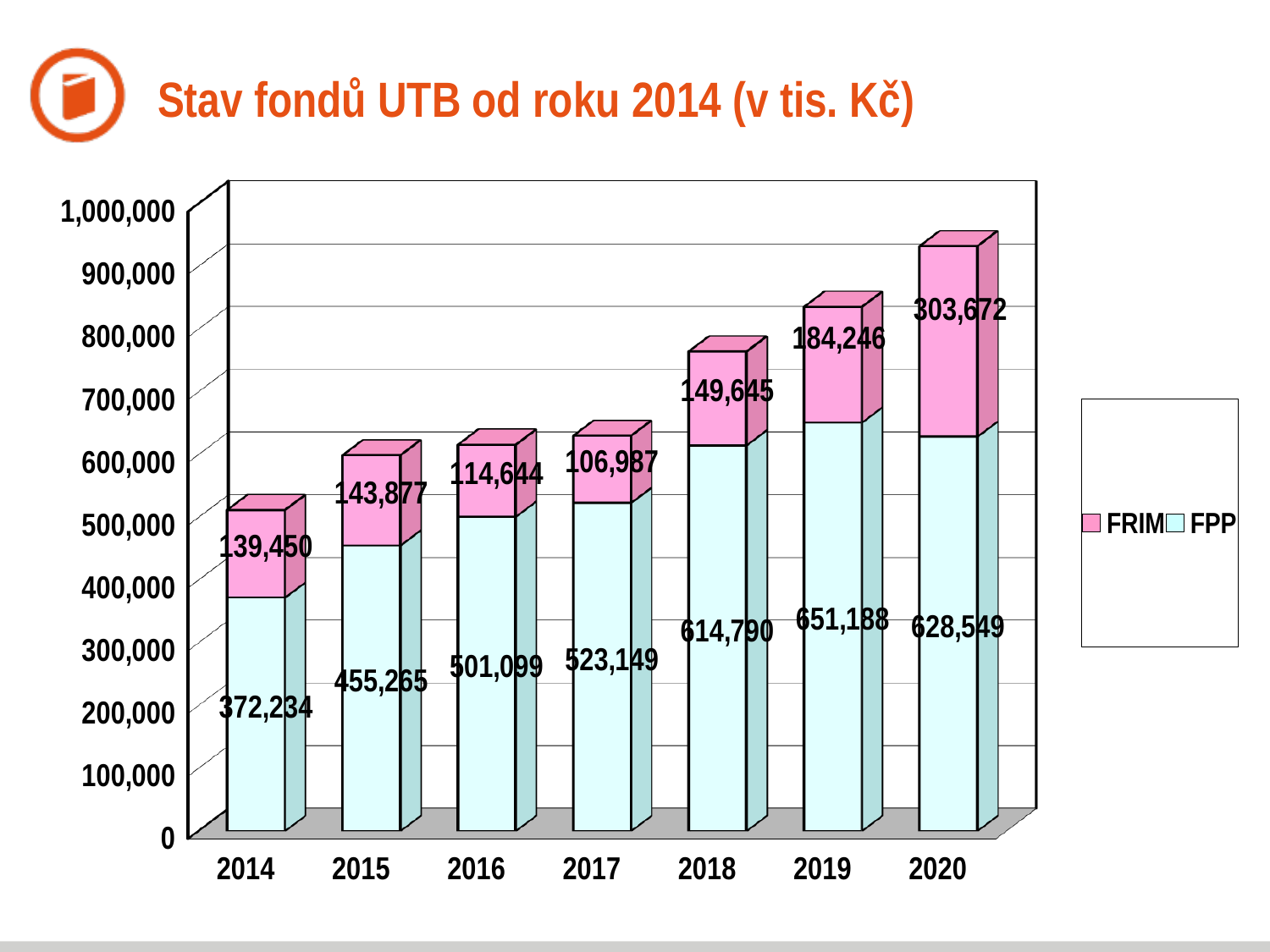
In which year is the FRIM value highest? 2020 How many series does the legend list? 2 How many years are shown on the x axis? 7 What is the total of the stacked bar for 2020? 932,221 Which year has the larger FRIM value, 2015 or 2016? 2015 What is the FRIM value for 2020? 303,672 What is the FPP value for 2014? 372,234 In which year is the FRIM value lowest? 2017 What is the difference between the FPP value in 2019 and the FPP value in 2020? 22,639 In which year is the FPP value highest? 2019 What kind of chart is shown on the slide? Stacked bar chart Do the total bar heights rise or fall from 2014 to 2020? Rise